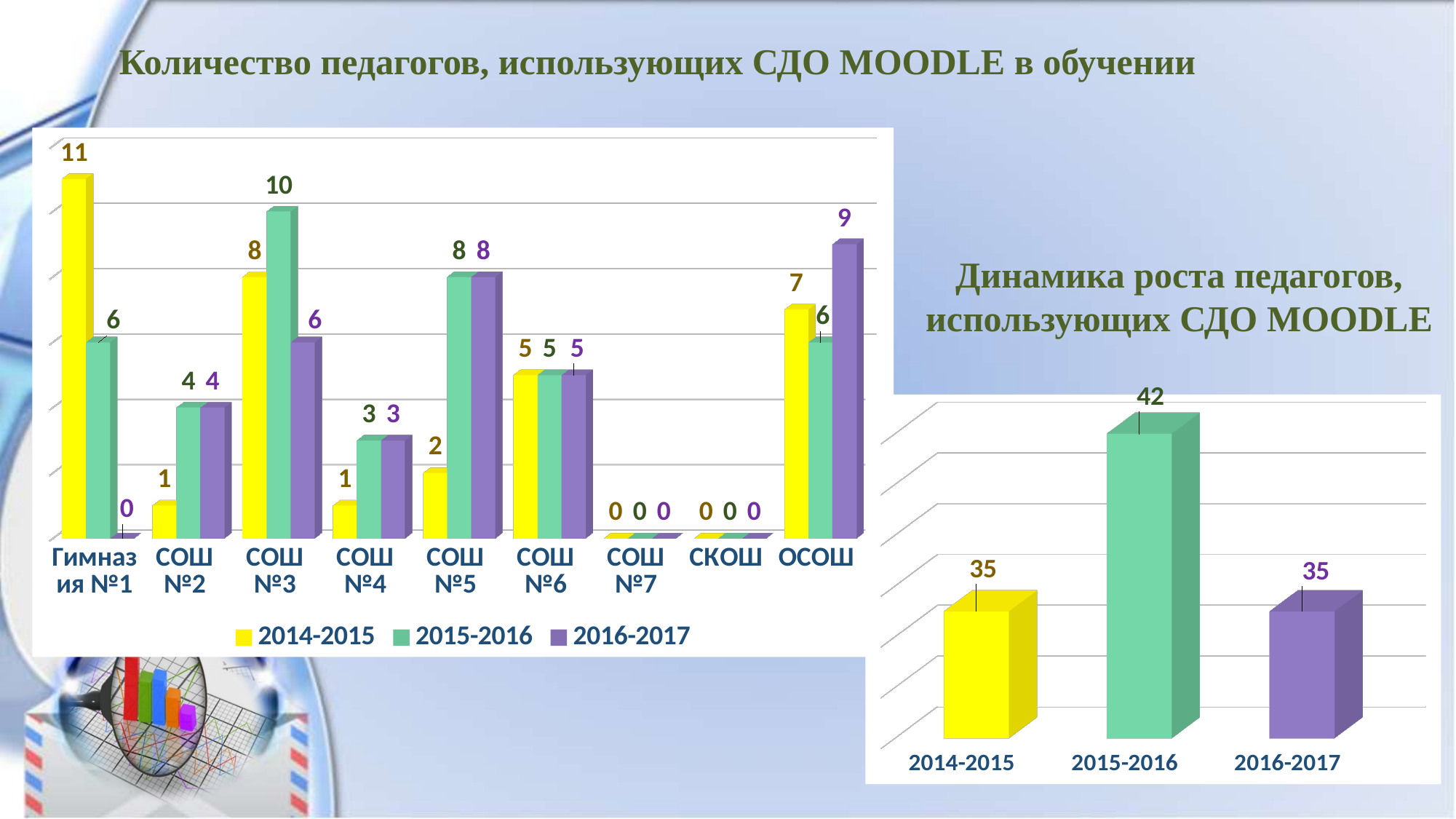
In the left chart, which is larger for СОШ №3: the 2015-2016 value or the 2016-2017 value? 2015-2016 In the right chart, what is the difference between the 2015-2016 and 2016-2017 values? 7 In the right chart (Динамика роста педагогов, использующих СДО MOODLE), what is the value for 2015-2016? 42 In the left chart, what is the difference between the 2014-2015 and 2016-2017 values for Гимназия №1? 11 In the right chart, which period has the highest value? 2015-2016 In the left chart, what is the value for ОСОШ in 2016-2017? 9 In the left chart, which school has the highest value for 2014-2015? Гимназия №1 In the left chart, how many schools are shown on the x axis? 9 In the left chart, what is the value for СОШ №3 in 2015-2016? 10 What kind of chart is the right chart? Bar chart In the left chart, how many series does the legend list? 3 In the left chart (Количество педагогов, использующих СДО MOODLE в обучении), what is the value for Гимназия №1 in 2014-2015? 11